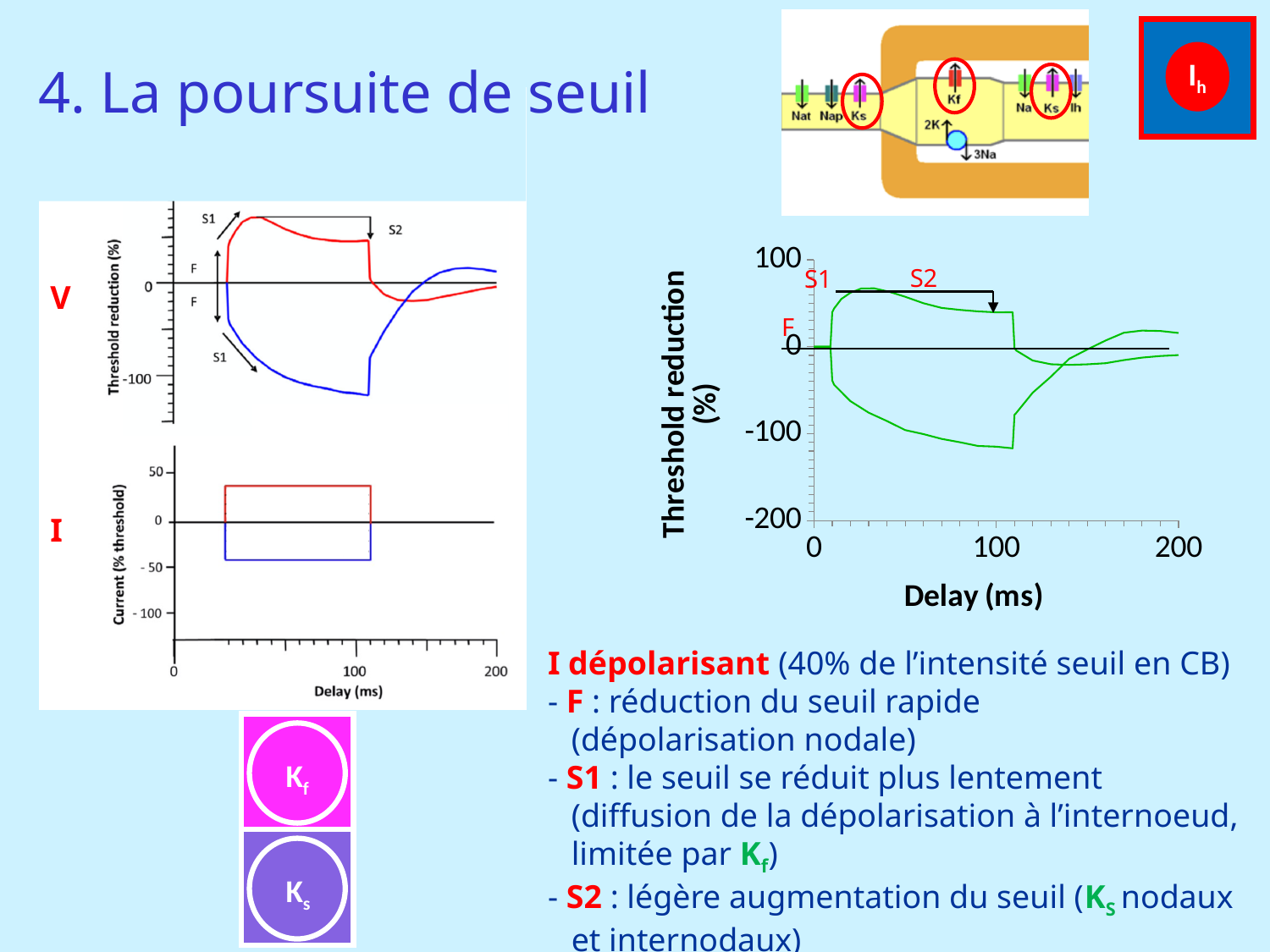
On the top-left chart (V), is the minimum of the blue curve greater or less than -100? less On the top-left chart (V), which curve reaches the lower minimum, the red one or the blue one? blue On the right-hand chart, what is the lowest value shown on the y axis? -200 On the right-hand chart, does the lower green curve rise or fall as the delay increases from about 10 ms to 100 ms? fall On the right-hand chart (Threshold reduction vs Delay), what kind of chart is it? line chart On the right-hand chart, is the minimum of the lower green curve greater or less than -100? less On the bottom-left chart (I), what is the title of the y axis? Current (% threshold) On the right-hand chart, what is the highest value shown on the x axis? 200 On the right-hand chart, is the peak of the upper green curve greater or less than 100? less On the right-hand chart, what is the title of the x axis? Delay (ms) On the bottom-left chart (I), what is the highest value shown on the y axis? 50